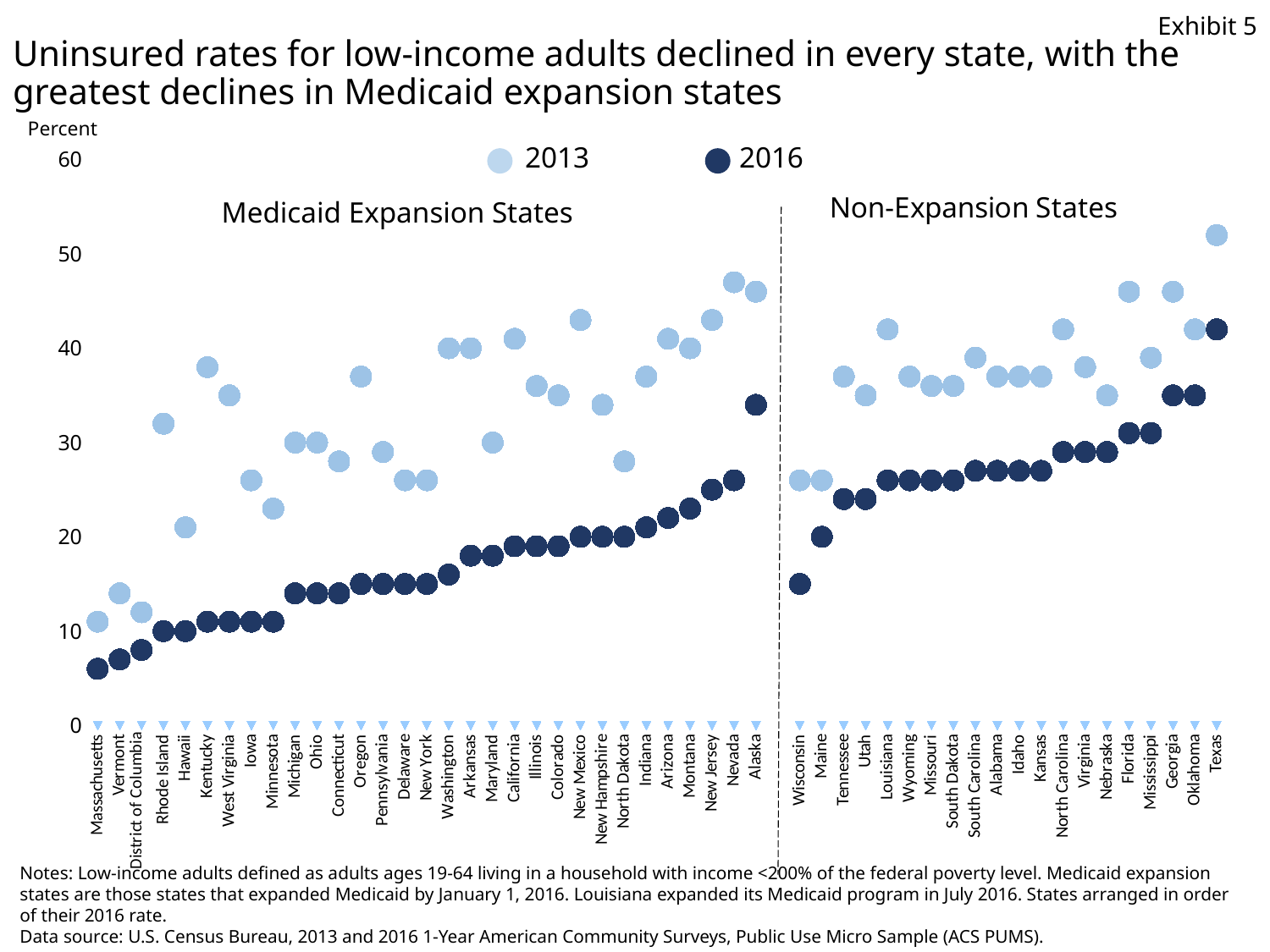
Which has the larger 2013 value, Kentucky or Hawaii? Kentucky Which state has the highest 2013 uninsured rate on the chart? Texas Which colour represents the 2016 series in the legend? Dark blue Is the 2016 value for Wisconsin greater or less than 20? less How many series does the legend list? 2 Which state has the lowest 2016 uninsured rate on the chart? Massachusetts Is the 2016 value for Massachusetts greater or less than 10? less Is the 2016 value for Alaska greater or less than 30? greater How many states are shown in the Non-Expansion States group? 20 Within each group, do the 2016 values rise or fall from left to right along the x axis? rise What kind of chart is shown on the slide? Dot plot (scatter chart)